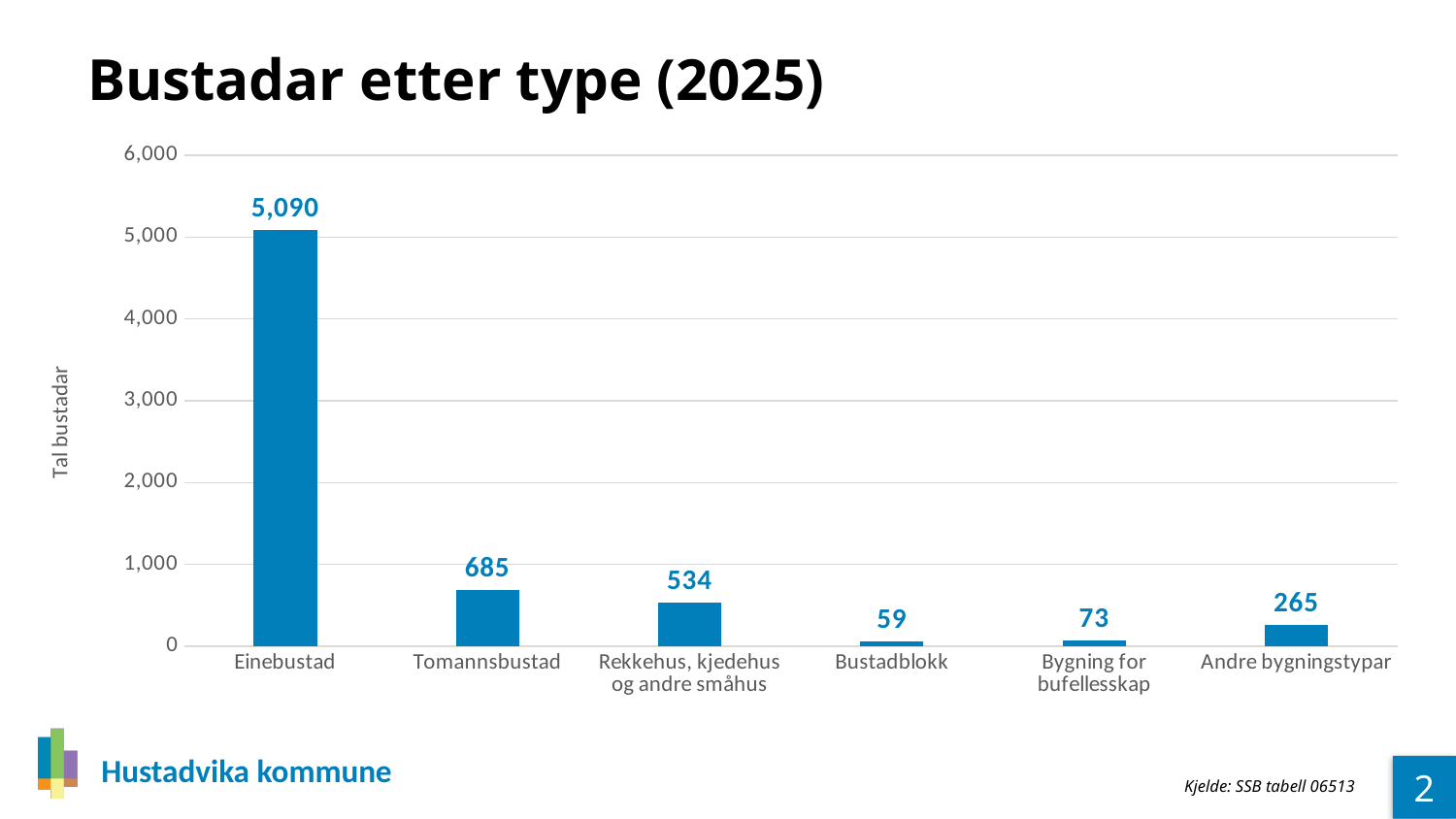
What kind of chart is shown on the slide? bar chart Which category has the highest value? Einebustad Which is larger, the value for Bygning for bufellesskap or the value for Bustadblokk? Bygning for bufellesskap What is the value for Bustadblokk? 59 What is the value for Tomannsbustad? 685 What is the difference between the values for Tomannsbustad and Rekkehus, kjedehus og andre småhus? 151 What is the value for Andre bygningstypar? 265 How many categories are shown on the x axis? 6 Which category has the lowest value? Bustadblokk Is the value for Einebustad greater or less than 5,000? greater What is the value for Einebustad? 5,090 What is the title of the chart? Bustadar etter type (2025)